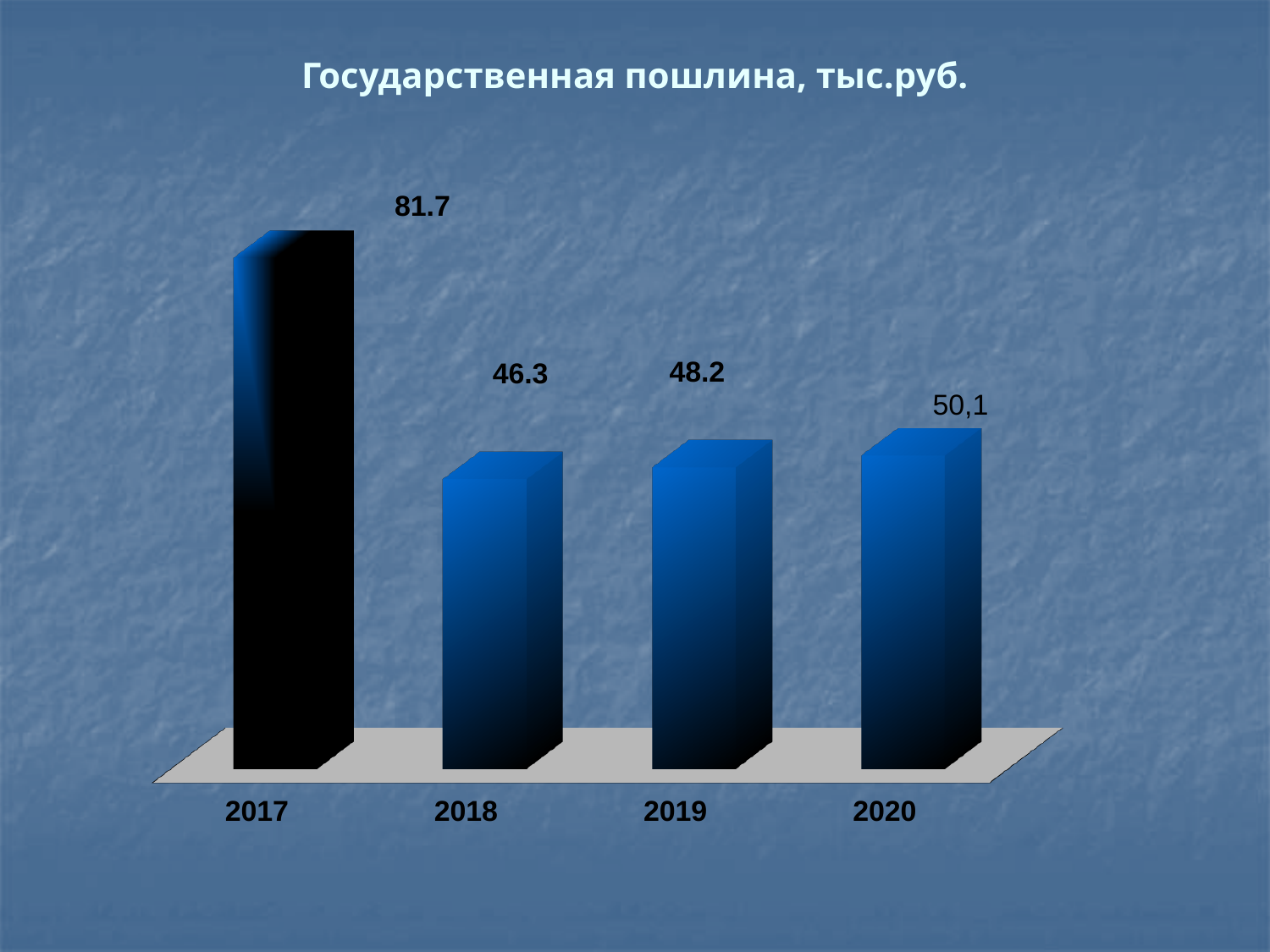
Which year has the lowest value? 2018 What is the value for 2020? 50,1 What is the value for 2017? 81.7 What is the difference between the values for 2017 and 2018? 35.4 What is the difference between the values for 2019 and 2018? 1.9 What is the value for 2019? 48.2 Which is larger, the value for 2019 or the value for 2018? 2019 Which year has the highest value? 2017 How many years are shown on the chart? 4 What is the title of the chart? Государственная пошлина, тыс.руб. What kind of chart is this? bar chart What is the value for 2018? 46.3